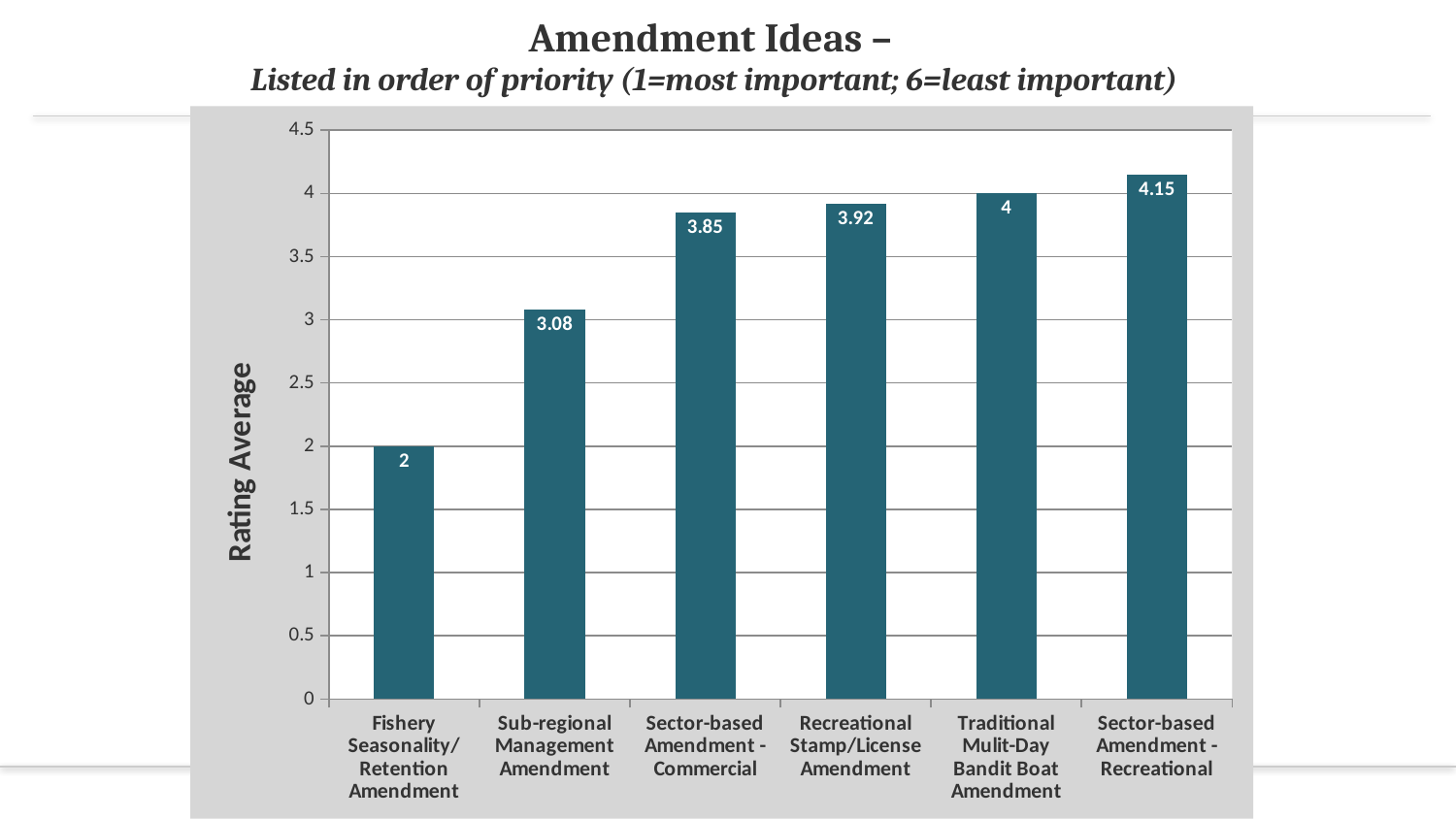
What is the rating average for the Fishery Seasonality/Retention Amendment? 2 What is the rating average for the Sector-based Amendment - Commercial? 3.85 Which amendment idea has the highest rating average? Sector-based Amendment - Recreational What is the label of the vertical axis? Rating Average What is the difference between the rating averages of the Sector-based Amendment - Recreational and the Fishery Seasonality/Retention Amendment? 2.15 Which amendment idea has the lowest rating average? Fishery Seasonality/Retention Amendment Is the rating average for the Sector-based Amendment - Commercial greater or less than 3.5? greater What is the rating average for the Sub-regional Management Amendment? 3.08 What type of chart is shown on the slide? Bar chart Which has a higher rating average: the Recreational Stamp/License Amendment or the Sub-regional Management Amendment? Recreational Stamp/License Amendment What is the rating average for the Traditional Mulit-Day Bandit Boat Amendment? 4 How many amendment ideas are shown in the chart? 6